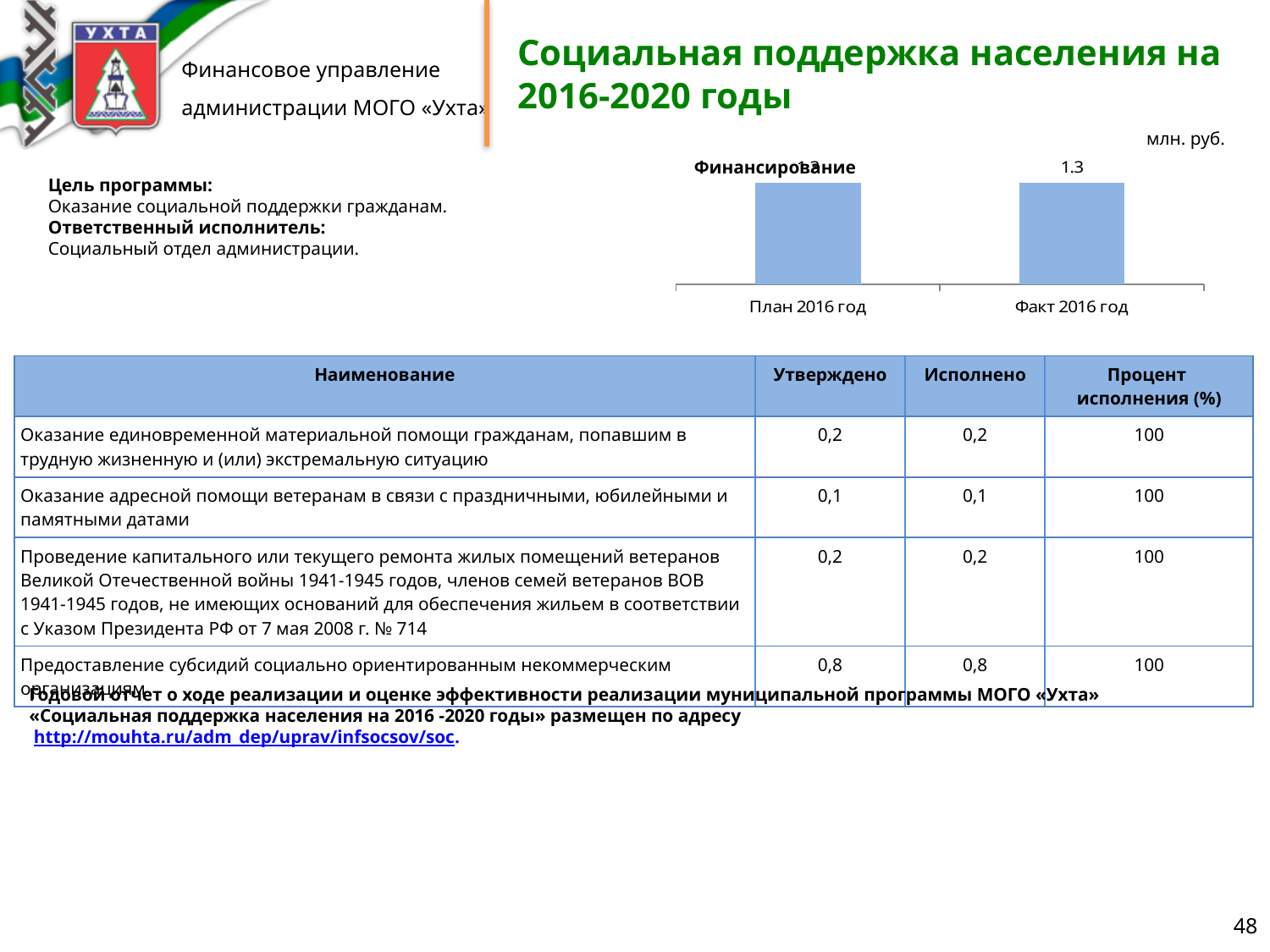
What unit is indicated above the Финансирование chart? млн. руб. What is the value for Факт 2016 год in the Финансирование chart? 1.3 What kind of chart is the Финансирование chart? bar chart What is the title of the chart on the slide? Финансирование What is the label of the first category on the x axis of the Финансирование chart? План 2016 год How many categories are shown on the x axis of the Финансирование chart? 2